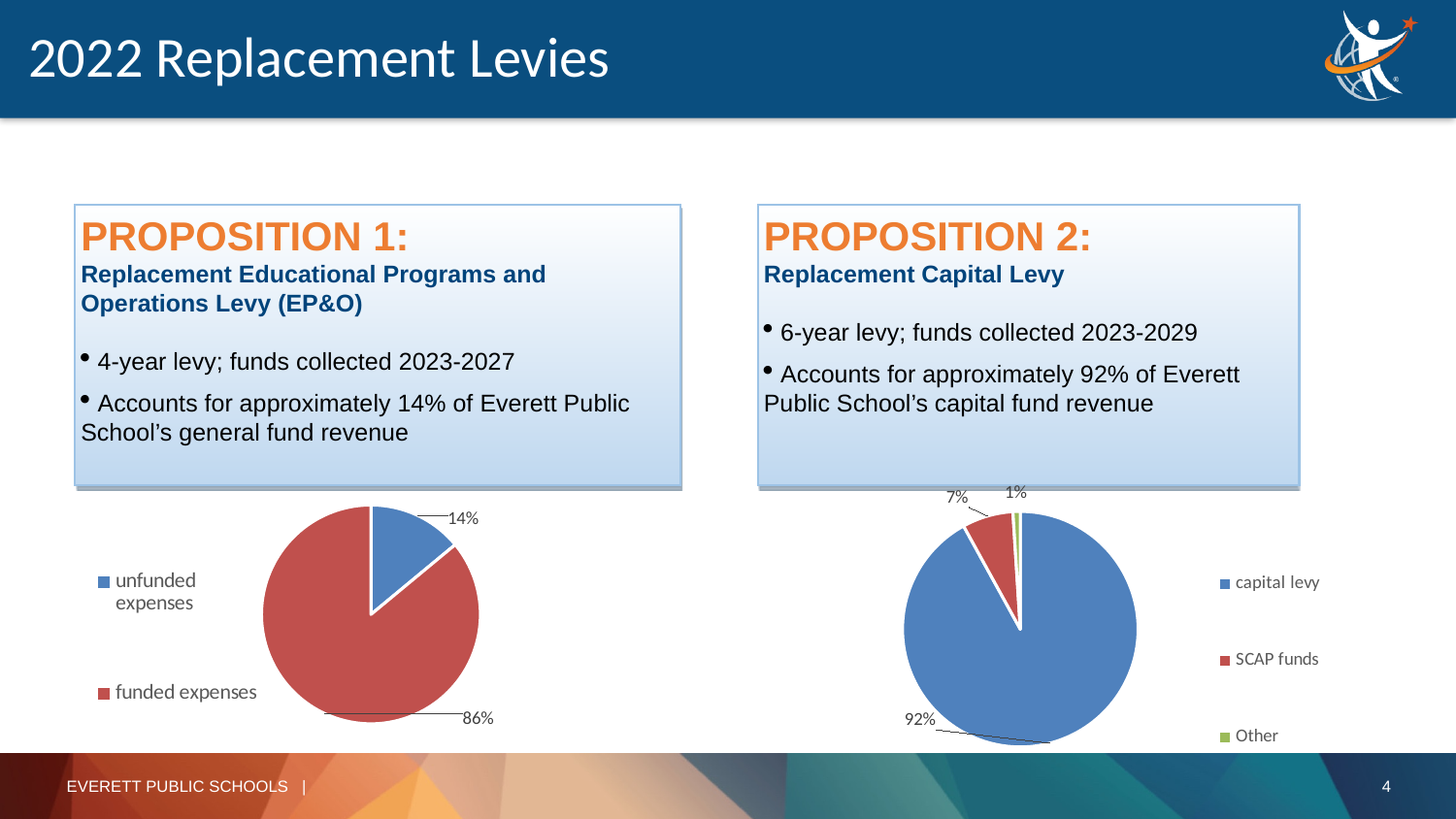
In the left pie chart, what share is labelled for funded expenses? 86% What kind of chart is the chart on the left of the slide? pie chart In the left pie chart, which slice is the largest? funded expenses How many entries does the legend of the right pie chart list? 3 In the right pie chart, which is larger, the SCAP funds slice or the Other slice? SCAP funds In the right pie chart, what share is labelled for SCAP funds? 7% In the right pie chart, what share is labelled for Other? 1% In the right pie chart, what share is labelled for capital levy? 92% In the left pie chart, what is the difference between the funded expenses share and the unfunded expenses share? 72% In the right pie chart, which slice is the smallest? Other In the left pie chart, what share is labelled for unfunded expenses? 14% How many slices does the left pie chart have? 2